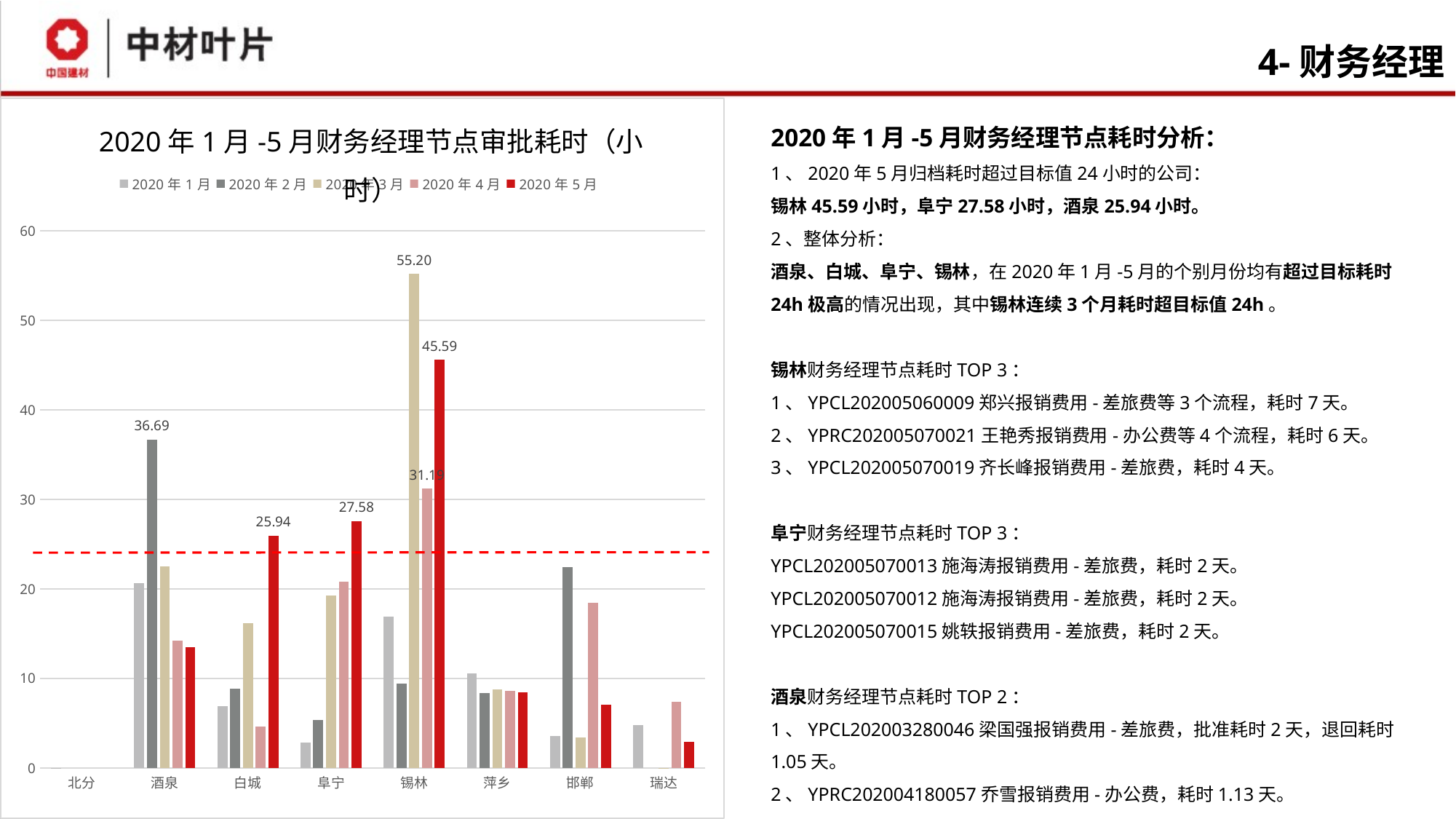
Which is larger: the 2020年5月 value for 锡林 or the 2020年2月 value for 酒泉? 锡林 2020年5月 How many categories are shown on the x axis? 8 Which category and month has the highest bar in the chart? 锡林, 2020年3月 What is the value for 酒泉 in the 2020年2月 series? 36.69 What is the value for 锡林 in the 2020年3月 series? 55.20 Is the value for 瑞达 in the 2020年1月 series greater or less than 10? less What kind of chart is shown on the slide? Bar chart What is the value for 白城 in the 2020年5月 series? 25.94 What is the difference between the 2020年3月 and 2020年5月 values for 锡林? 9.61 How many series does the legend list? 5 What is the value for 阜宁 in the 2020年5月 series? 27.58 What is the value for 锡林 in the 2020年5月 series? 45.59